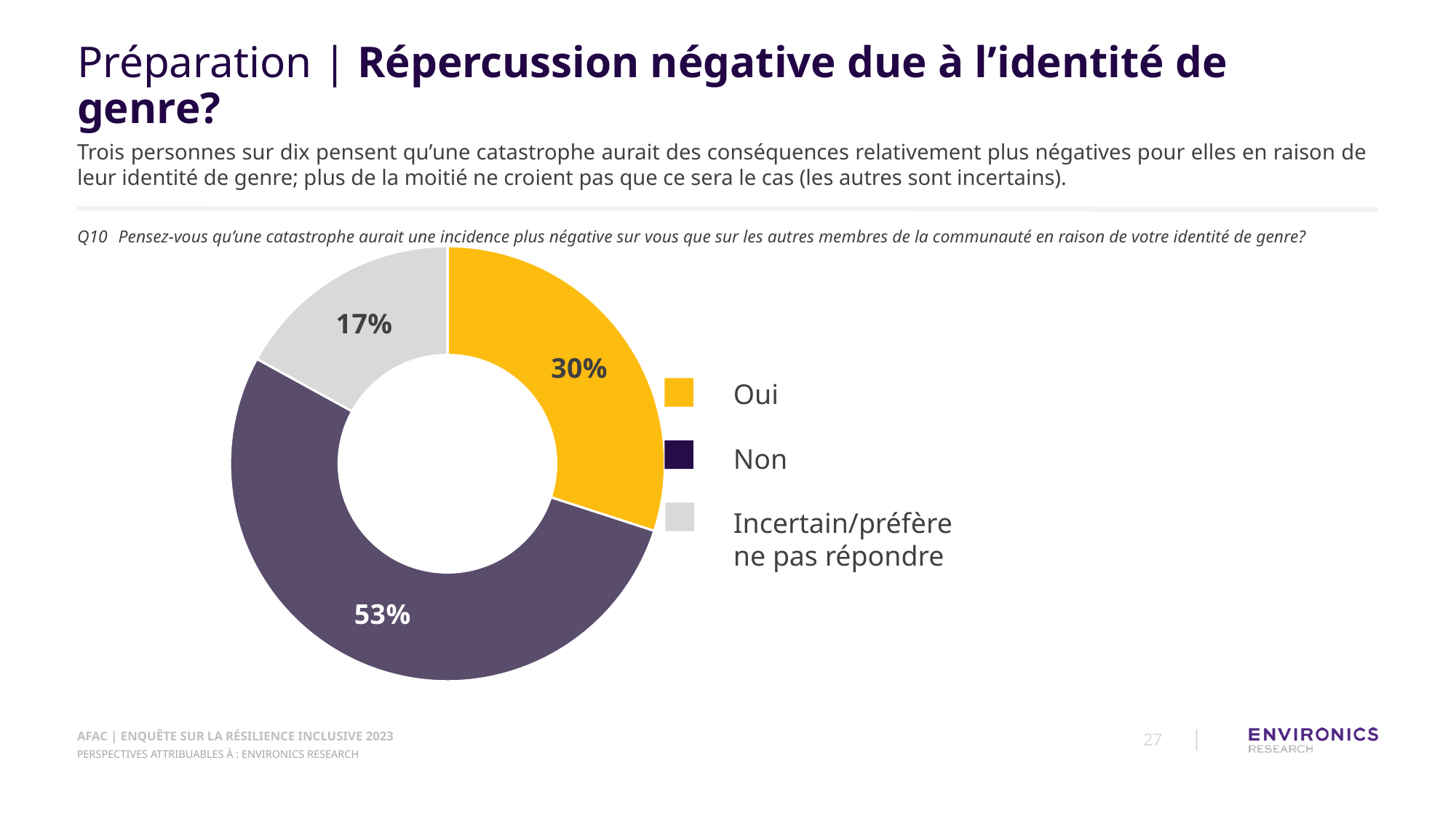
What is the difference in percentage points between "Oui" and "Incertain/préfère ne pas répondre"? 13 What kind of chart is shown on the slide? Doughnut (pie) chart How many categories are shown in the chart? 3 Which response has the largest share of the chart? Non What colour represents "Oui" in the chart? Yellow What percentage of respondents answered "Non"? 53% Which response has the smallest share of the chart? Incertain/préfère ne pas répondre What is the difference in percentage points between "Non" and "Oui"? 23 What is the combined share of "Oui" and "Non"? 83% What percentage of respondents answered "Oui"? 30% Which is larger, the share for "Oui" or the share for "Non"? Non What percentage of respondents answered "Incertain/préfère ne pas répondre"? 17%